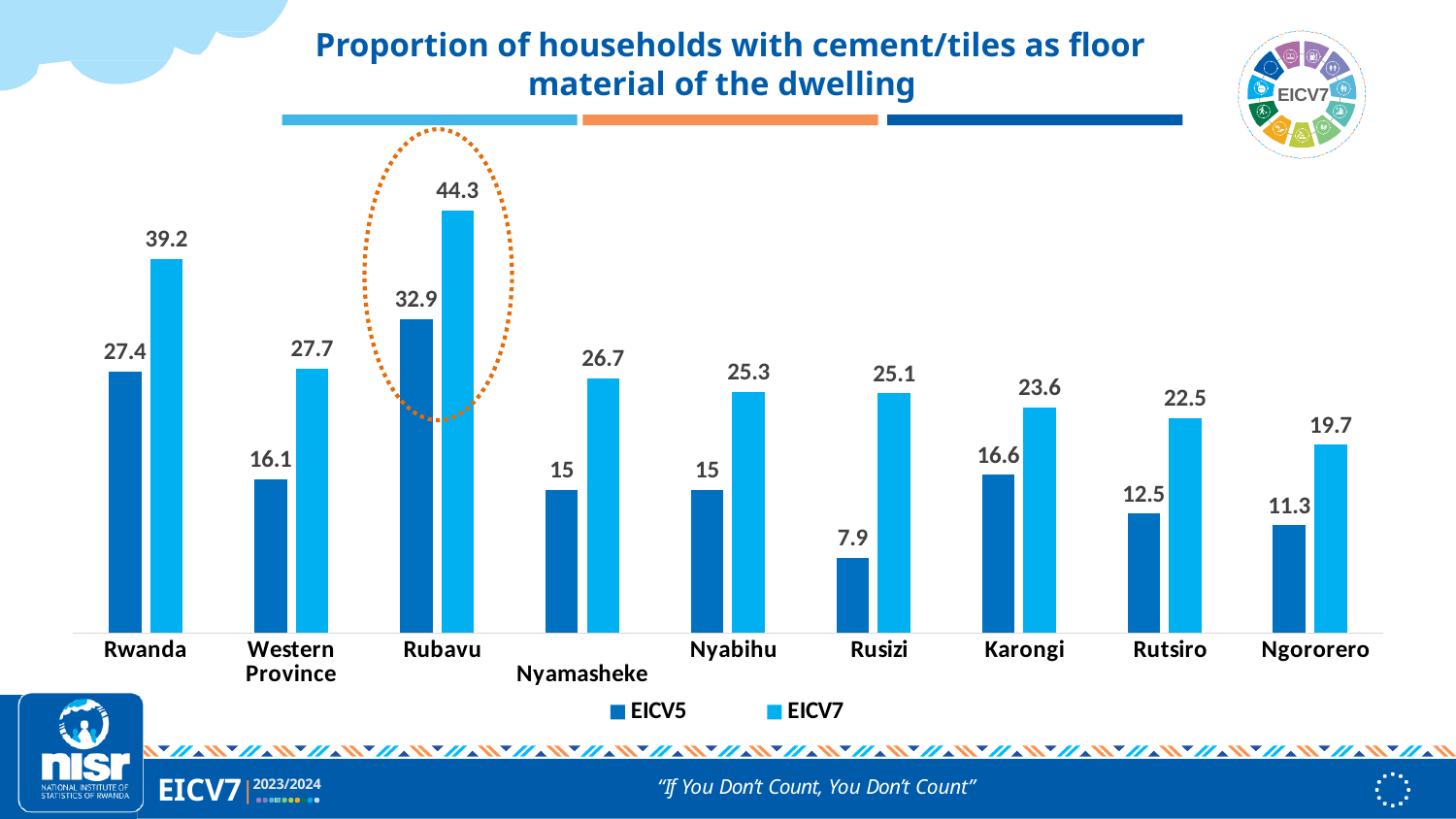
Which category has the lowest EICV5 value? Rusizi What kind of chart is shown on the slide? Bar chart What is the difference between the EICV7 values for Rubavu and Ngororero? 24.6 What is the EICV5 value for Rusizi? 7.9 Which category is highlighted with a dotted orange oval? Rubavu Which category has the highest EICV7 value? Rubavu How many categories are shown on the x axis? 9 What is the EICV7 value for Rubavu? 44.3 How many series does the legend list? 2 What is the EICV7 value for Western Province? 27.7 Which is larger, the EICV5 value for Karongi or the EICV5 value for Rutsiro? Karongi What is the difference between the EICV7 and EICV5 values for Rwanda? 11.8